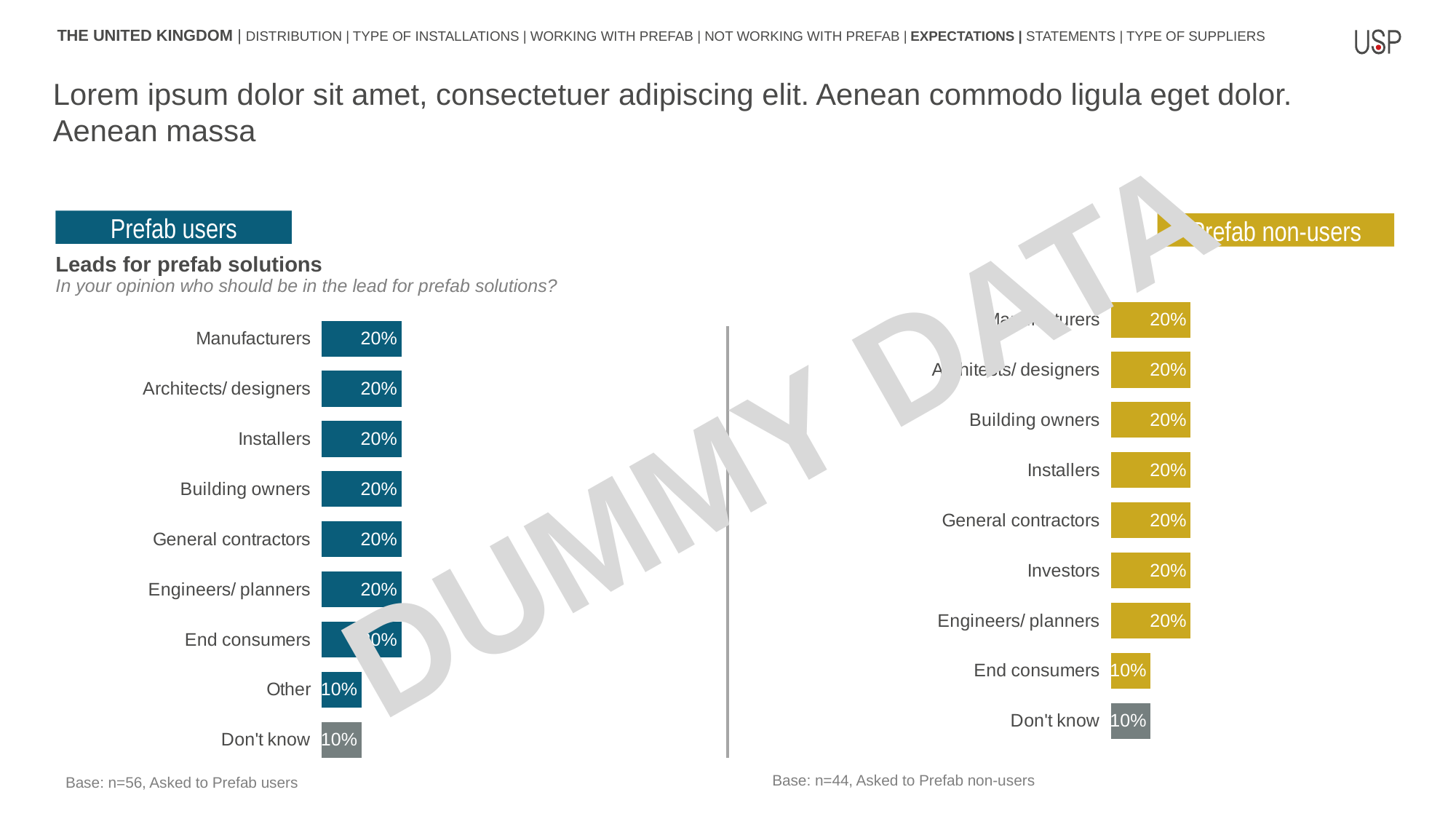
How many categories are shown in the Prefab non-users chart? 9 In the Prefab users chart, what is the value for Installers? 20% In the Prefab users chart, what is the value for Don't know? 10% In the Prefab non-users chart, what is the value for End consumers? 10% In the Prefab users chart, what is the difference between the values for Building owners and Other? 10% What is the base (sample size) stated for the Prefab users chart? n=56 In the Prefab users chart, what is the value for Other? 10% What kind of chart is the Prefab users chart? Bar chart In the Prefab users chart, which is larger, the value for Manufacturers or the value for Don't know? Manufacturers In the Prefab non-users chart, which is larger, the value for General contractors or the value for End consumers? General contractors In the Prefab non-users chart, what is the value for Investors? 20% In the Prefab non-users chart, what is the value for Don't know? 10%